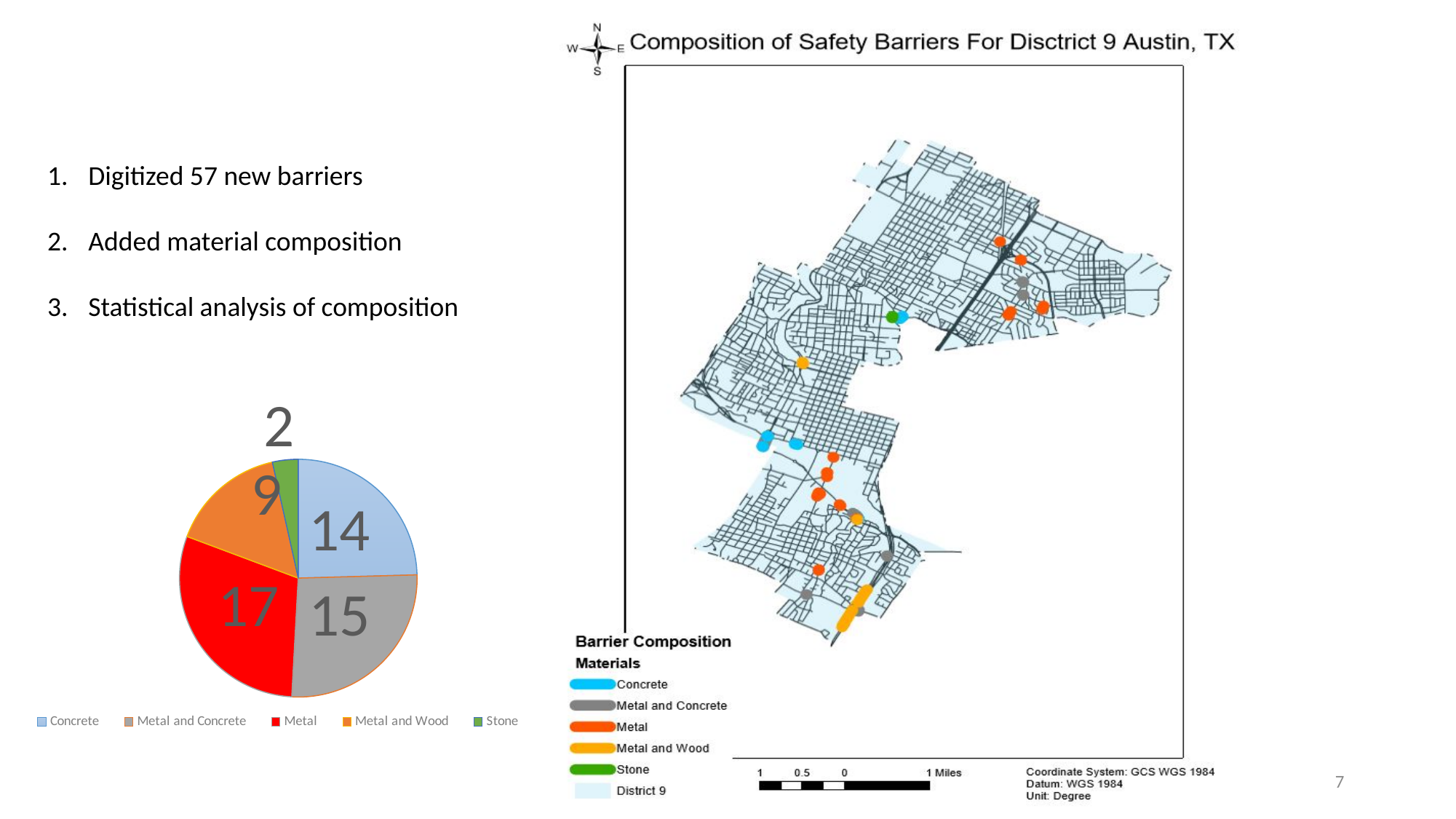
What is the total of all the slices in the pie chart? 57 Which category has the smallest slice in the pie chart? Stone What type of chart is shown on the left of the slide? pie chart In the pie chart, what is the value for Metal? 17 In the pie chart, which is larger: Metal and Concrete or Metal and Wood? Metal and Concrete What is the difference between the Metal and Concrete values in the pie chart? 3 What colour is the Metal slice in the pie chart? red In the pie chart, what is the value for Metal and Wood? 9 Which category has the largest slice in the pie chart? Metal In the pie chart, what is the value for Concrete? 14 In the pie chart, what is the value for Stone? 2 How many categories does the pie chart show? 5